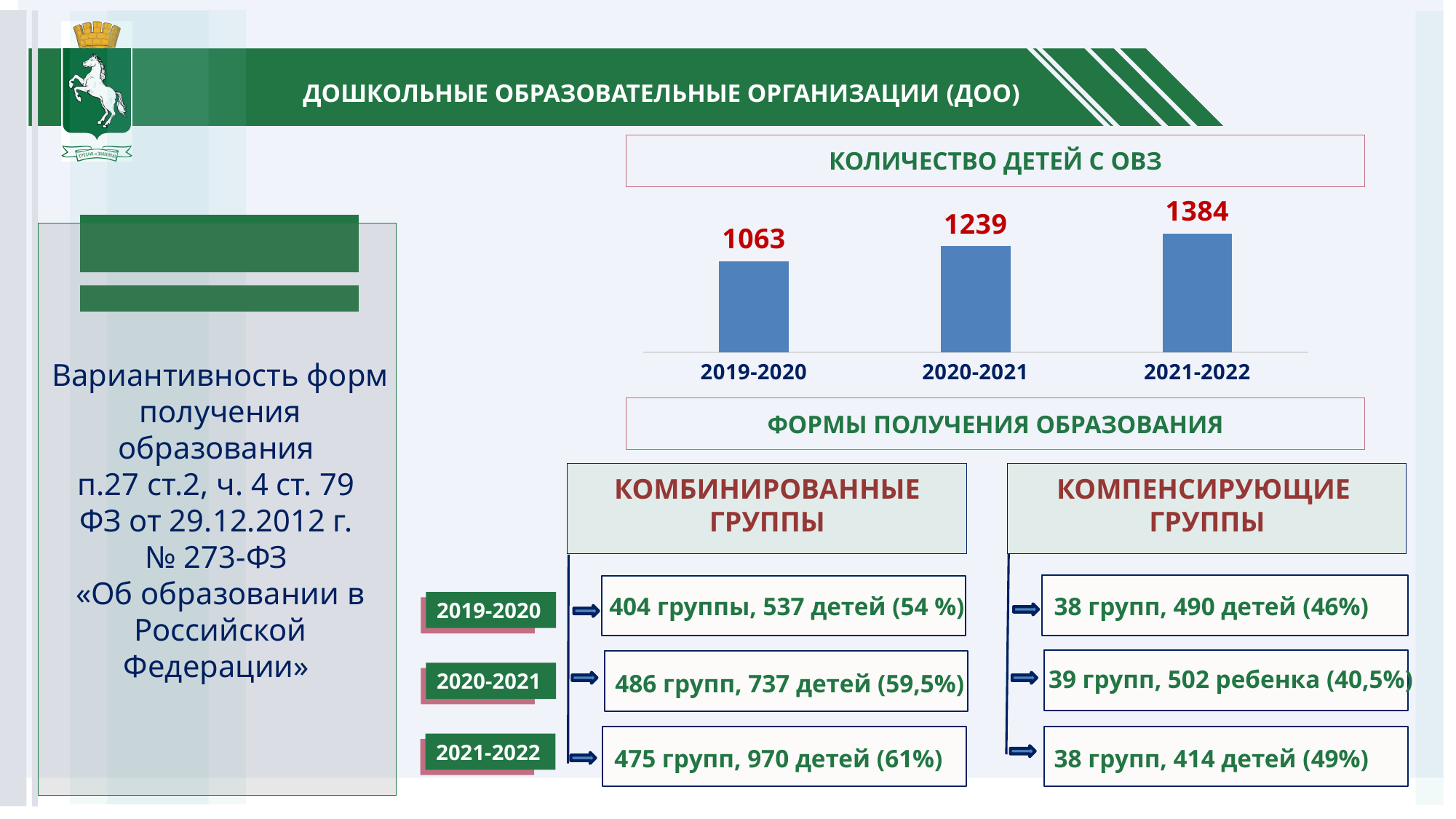
What is the value for 2020-2021 in the chart 'КОЛИЧЕСТВО ДЕТЕЙ С ОВЗ'? 1239 What is the difference between the values for 2020-2021 and 2019-2020 in the chart 'КОЛИЧЕСТВО ДЕТЕЙ С ОВЗ'? 176 What is the value for 2019-2020 in the chart 'КОЛИЧЕСТВО ДЕТЕЙ С ОВЗ'? 1063 Which period has the highest value in the chart 'КОЛИЧЕСТВО ДЕТЕЙ С ОВЗ'? 2021-2022 What is the title of the bar chart on the slide? КОЛИЧЕСТВО ДЕТЕЙ С ОВЗ What is the value for 2021-2022 in the chart 'КОЛИЧЕСТВО ДЕТЕЙ С ОВЗ'? 1384 Do the values in the chart 'КОЛИЧЕСТВО ДЕТЕЙ С ОВЗ' rise or fall from 2019-2020 to 2021-2022? rise Which period has the lowest value in the chart 'КОЛИЧЕСТВО ДЕТЕЙ С ОВЗ'? 2019-2020 In the chart 'КОЛИЧЕСТВО ДЕТЕЙ С ОВЗ', which is larger: the value for 2020-2021 or 2021-2022? 2021-2022 What is the difference between the values for 2021-2022 and 2019-2020 in the chart 'КОЛИЧЕСТВО ДЕТЕЙ С ОВЗ'? 321 What kind of chart is 'КОЛИЧЕСТВО ДЕТЕЙ С ОВЗ'? bar chart How many periods are shown in the chart 'КОЛИЧЕСТВО ДЕТЕЙ С ОВЗ'? 3